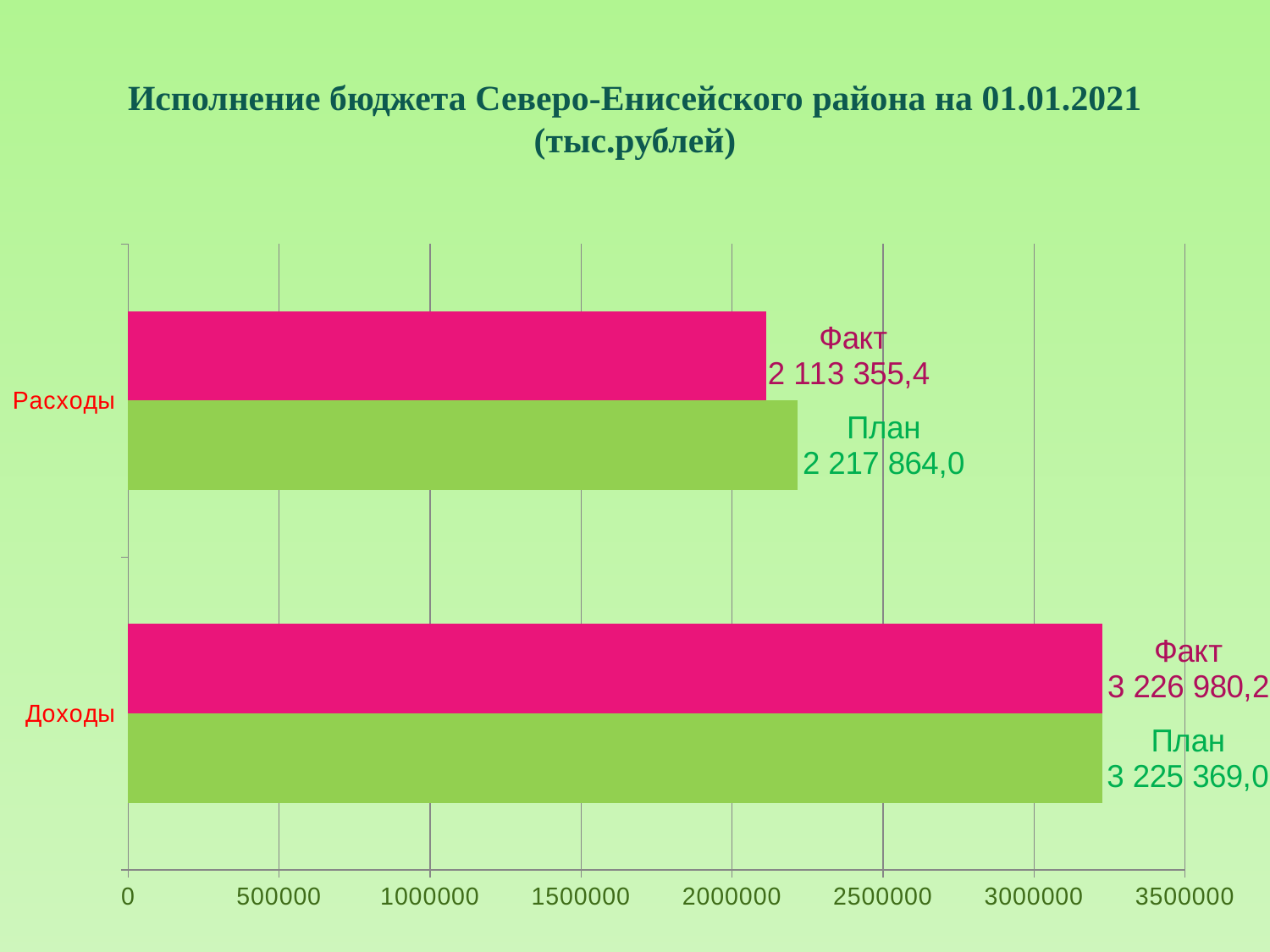
What is the difference between the План and Факт values for Расходы? 104 508,6 How many categories are shown on the chart? 2 Which bar has the lowest value on the chart? Расходы Факт What is the Факт value for Доходы? 3 226 980,2 What is the Факт value for Расходы? 2 113 355,4 What is the План value for Доходы? 3 225 369,0 What kind of chart is shown on the slide? Bar chart What is the План value for Расходы? 2 217 864,0 What is the difference between the Факт and План values for Доходы? 1 611,2 For Расходы, which is larger: План or Факт? План Is the Факт value for Расходы greater or less than 2000000? greater Which bar has the highest value on the chart? Доходы Факт